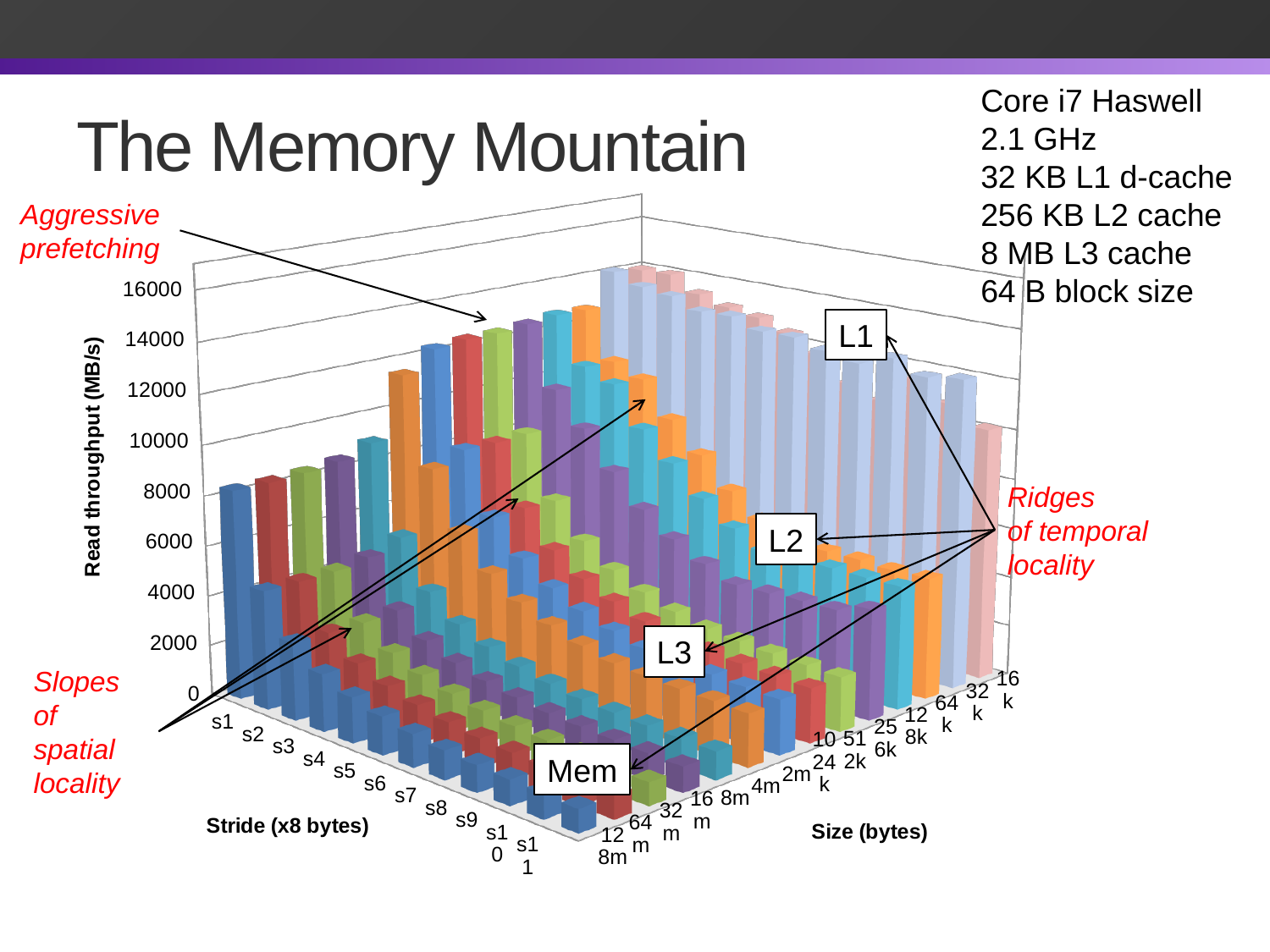
What is the highest value shown on the read throughput axis? 16000 What kind of chart is shown on the slide? 3D bar chart Which memory level region (L1, L2, L3 or Mem) has the lowest read throughput? Mem What is the title of the chart on the slide? The Memory Mountain Is the read throughput for stride s1 in the L1 region larger or smaller than for stride s1 in the Mem region? larger Which memory level region (L1, L2, L3 or Mem) has the highest read throughput? L1 For a fixed size, does read throughput rise or fall as the stride increases from s1 to s11? fall What is the label of the vertical axis of the chart? Read throughput (MB/s) How many stride categories (s1 through s11) are shown on the stride axis? 11 Is the read throughput for stride s11 in the Mem region greater or less than 4000? less Which stride has the highest read throughput in the chart? s1 Is the read throughput for stride s1 in the L1 region greater or less than 12000? greater